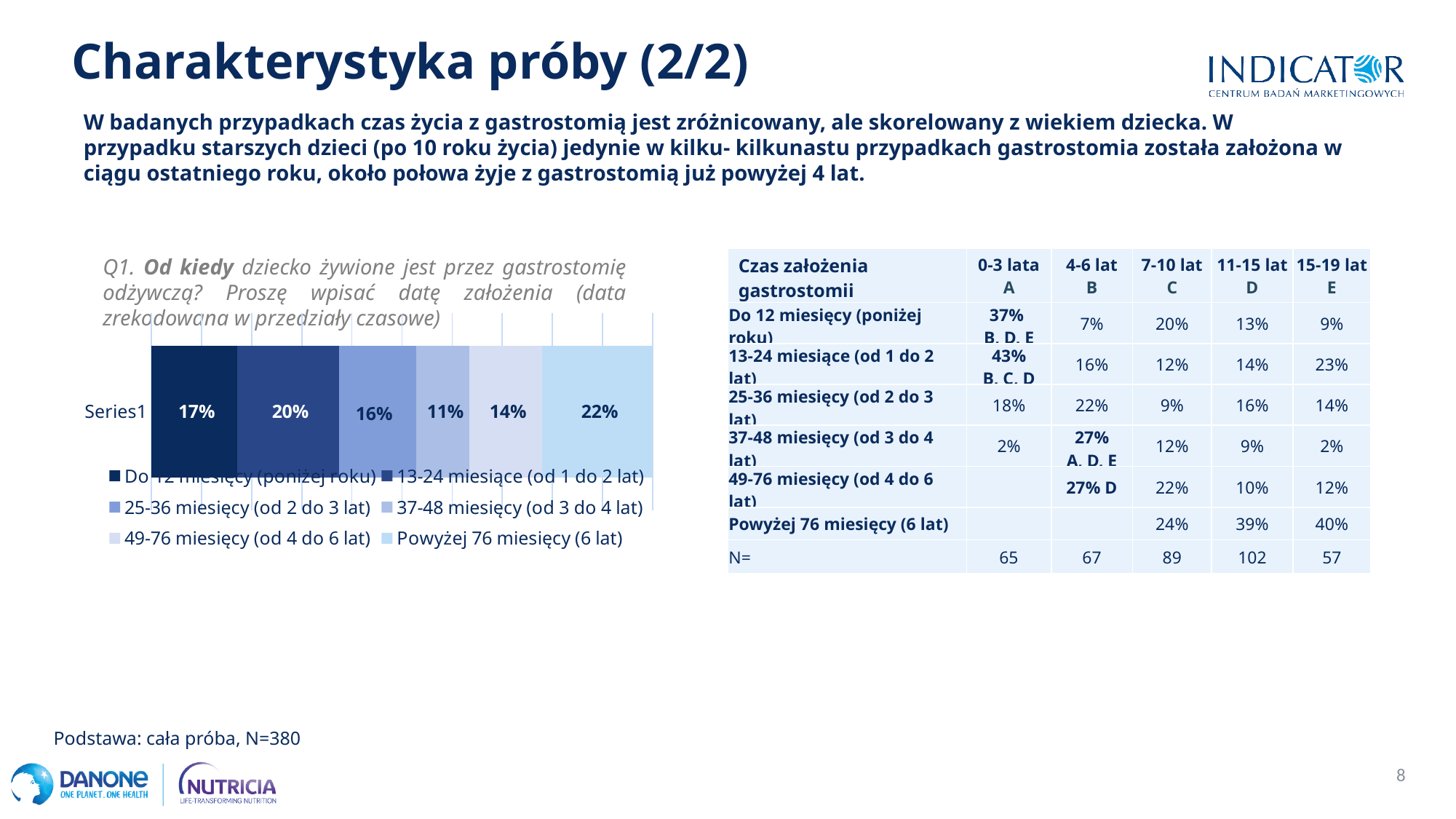
Which is larger in the bar chart: the '13-24 miesiące (od 1 do 2 lat)' segment or the '25-36 miesięcy (od 2 do 3 lat)' segment? 13-24 miesiące (od 1 do 2 lat) What kind of chart is shown on the slide? stacked bar chart What is the difference between the 'Powyżej 76 miesięcy (6 lat)' segment and the '49-76 miesięcy (od 4 do 6 lat)' segment in the bar chart? 8% How many categories does the legend of the bar chart list? 6 Which legend category has the largest segment in the bar chart? Powyżej 76 miesięcy (6 lat) What is the value of the 'Powyżej 76 miesięcy (6 lat)' segment in the bar chart? 22% What is the value of the '13-24 miesiące (od 1 do 2 lat)' segment in the bar chart? 20% What is the value of the 'Do 12 miesięcy (poniżej roku)' segment in the bar chart? 17% What is the value of the '37-48 miesięcy (od 3 do 4 lat)' segment in the bar chart? 11% What is the value of the '25-36 miesięcy (od 2 do 3 lat)' segment in the bar chart? 16% Which legend category has the smallest segment in the bar chart? 37-48 miesięcy (od 3 do 4 lat) What is the total of all segments in the stacked bar? 100%